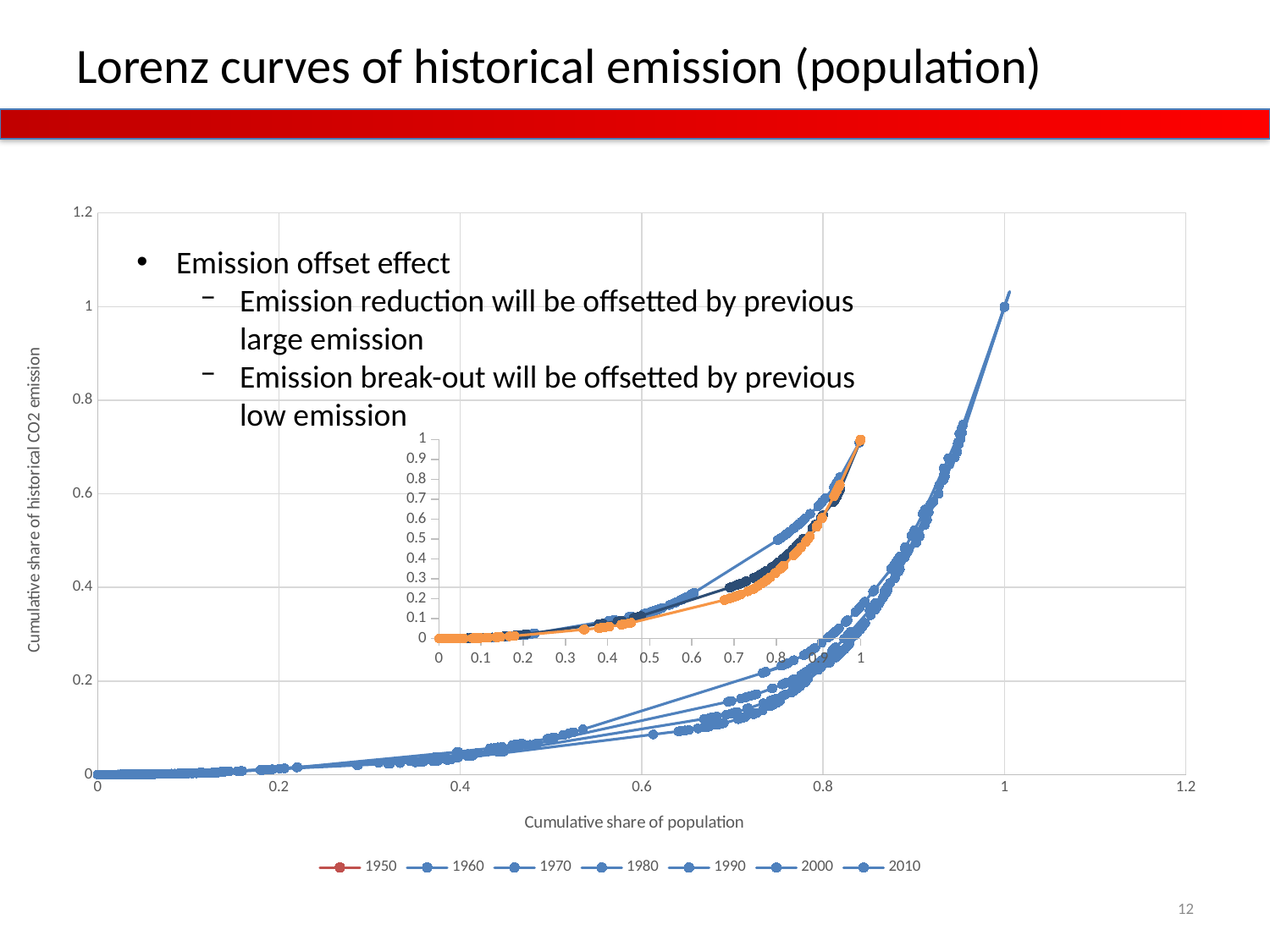
In the large chart, what is the cumulative share of historical CO2 emission when the cumulative share of population reaches 1? 1 In the large chart, at a cumulative share of population of 0.6, is the cumulative share of historical CO2 emission greater or less than 0.2? less Do the curves in the large chart rise or fall as the cumulative share of population increases? rise In the large chart, at a cumulative share of population of 0.8, is the cumulative share of historical CO2 emission greater or less than 0.4? less In the small inset chart, at an x value of 0.5, is the plotted value greater or less than 0.2? less How many charts are shown on the slide? 2 What kind of chart is the large chart on the slide? line chart How many series does the legend of the large chart list? 7 Which series in the legend of the large chart is drawn in red? 1950 What is the title of the x axis of the large chart? Cumulative share of population What kind of chart is the small inset chart on the slide? line chart Do the curves in the small inset chart rise or fall along the x axis? rise